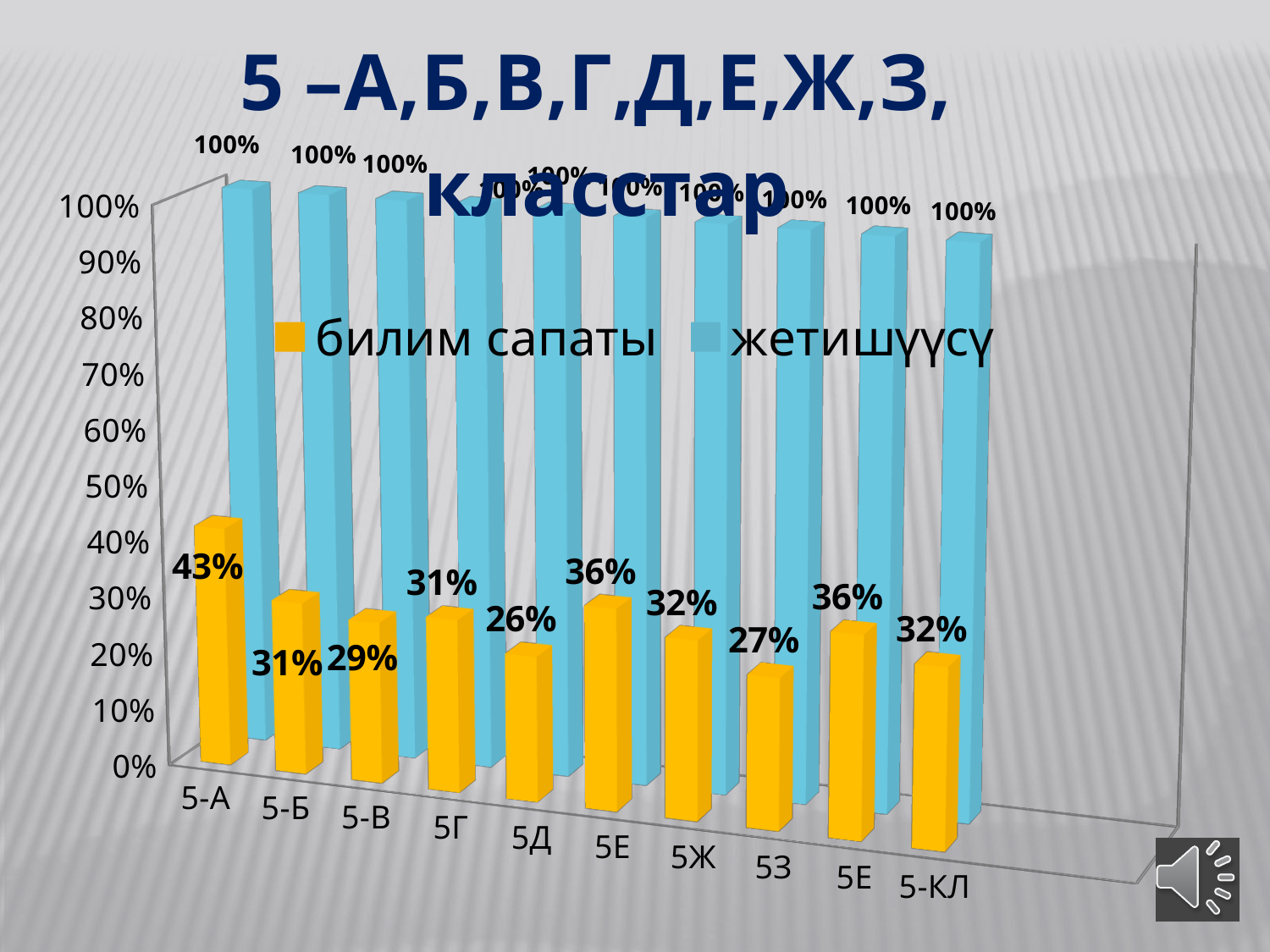
What is the жетишүүсү value for 5-Б? 100% Which class has the lowest билим сапаты value? 5Д Which class has the highest билим сапаты value? 5-А What is the difference between the билим сапаты values for 5-А and 5Д? 17% Which has the larger билим сапаты value, 5-Б or 5-В? 5-Б How many classes (categories) are shown on the x axis? 10 What is the билим сапаты value for 5-А? 43% How many series does the legend list? 2 What is the билим сапаты value for 5Д? 26% What kind of chart is shown on the slide? Bar chart What are the two series named in the legend? билим сапаты and жетишүүсү What is the билим сапаты value for 5З? 27%